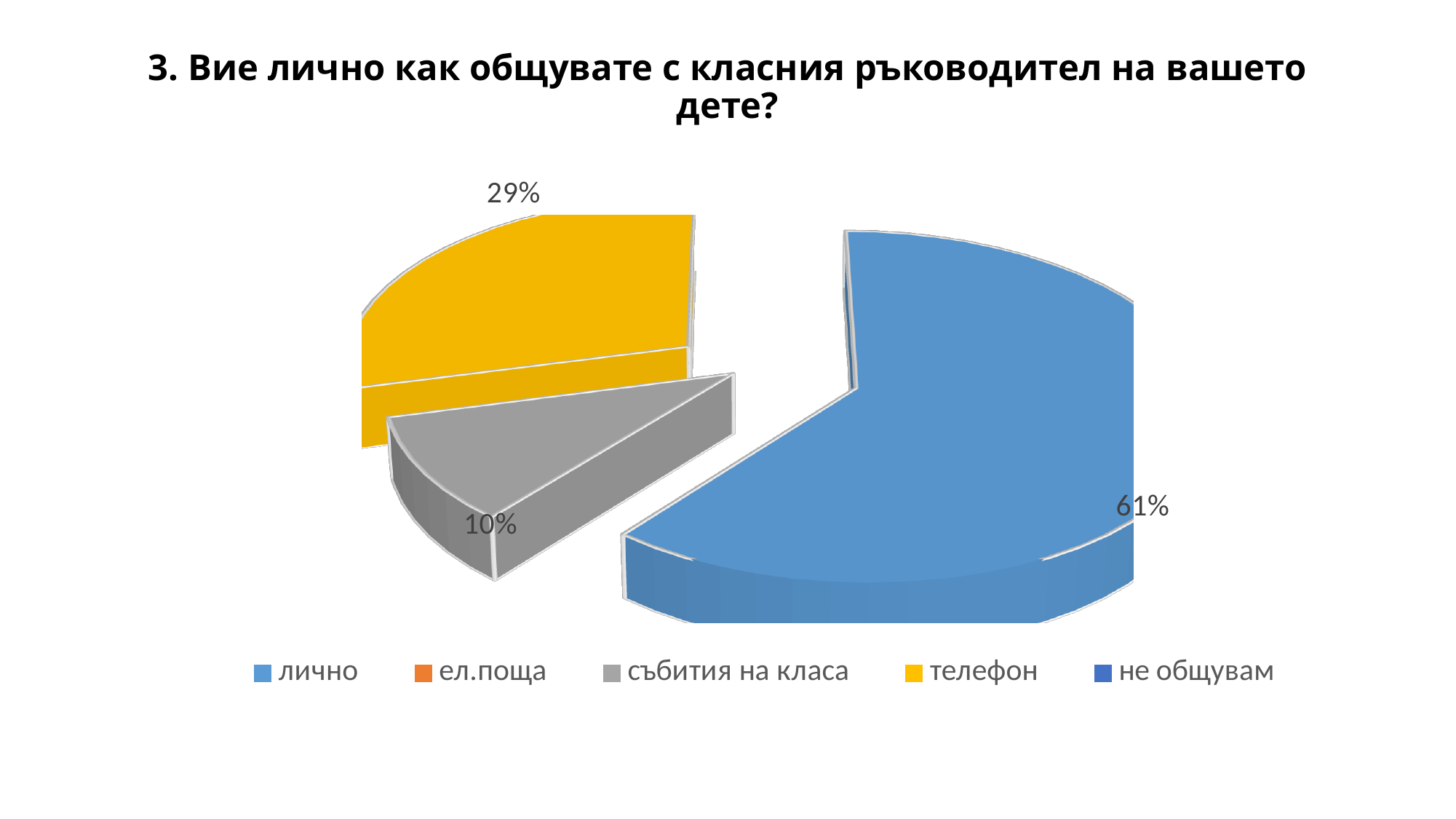
What is the value shown for "събития на класа"? 10% How many entries does the legend list? 5 What share of the pie does the "лично" slice represent? 61% What is the difference between the "лично" and "телефон" shares? 32% What kind of chart is shown on the slide? pie chart What is the difference between the "телефон" and "събития на класа" shares? 19% What colour is the "телефон" slice? yellow Which of the labelled slices is the smallest? събития на класа What is the value shown for "телефон"? 29% Which category has the largest slice of the pie? лично Which is larger, the share for "телефон" or the share for "събития на класа"? телефон How many slices with data labels are visible in the pie? 3